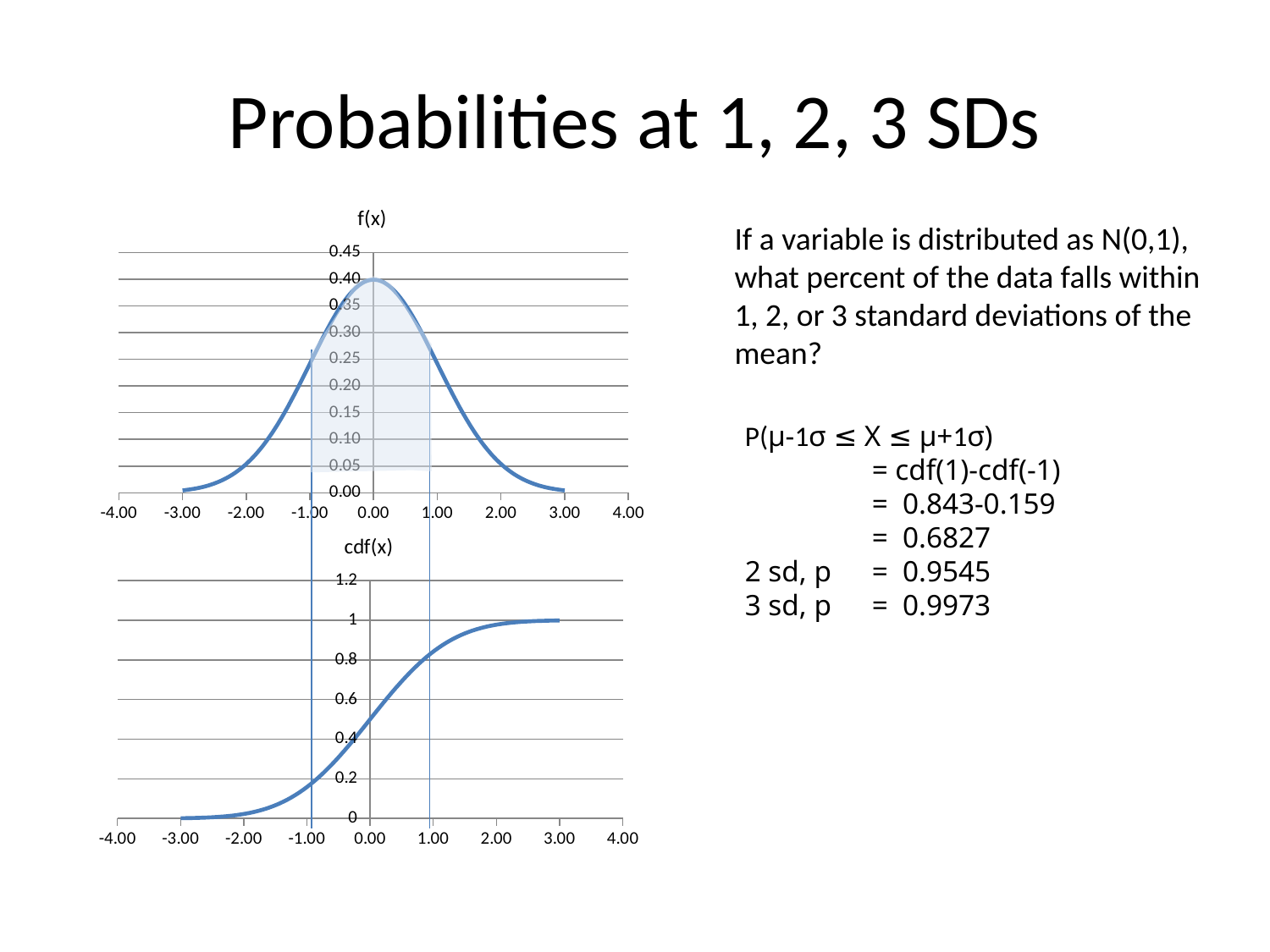
In the f(x) chart, at which x value does the curve reach its highest point? 0.00 In the f(x) chart, is the value of the curve at x = 2.00 greater or less than 0.10? less In the cdf(x) chart, is the value of the curve at x = 2.00 greater or less than 0.8? greater In the cdf(x) chart, is the value of the curve at x = -2.00 greater or less than 0.2? less What kind of chart is the bottom chart titled cdf(x)? line chart In the f(x) chart, is the curve higher at x = 0.00 or at x = 1.00? 0.00 In the cdf(x) chart, does the curve rise or fall as x increases? rises What is the highest tick label on the vertical axis of the cdf(x) chart? 1.2 In the cdf(x) chart, is the curve higher at x = 1.00 or at x = -1.00? 1.00 What kind of chart is the top chart titled f(x)? line chart